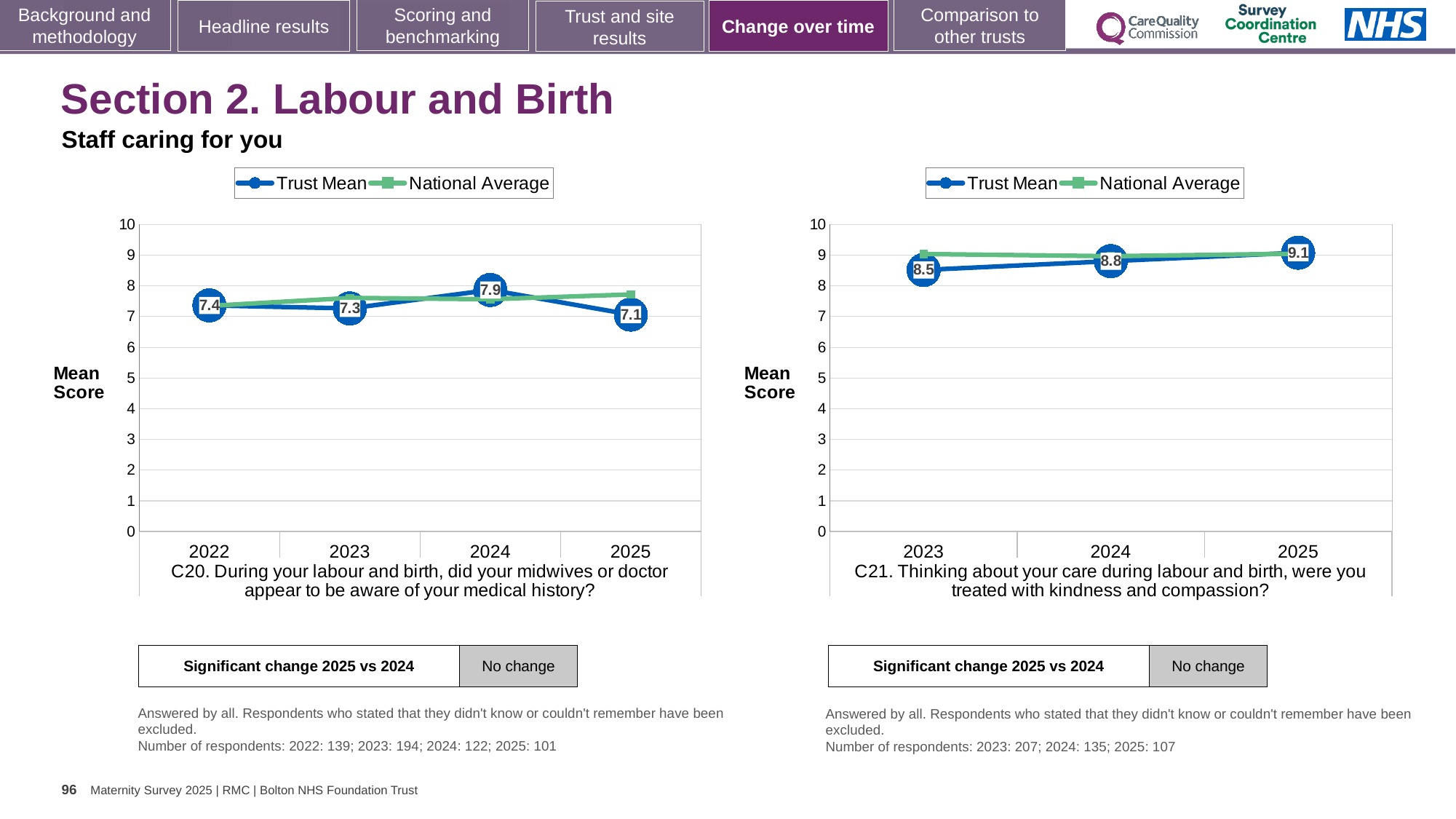
In the left chart (C20), is the Trust Mean higher in 2022 or 2023? 2022 In the left chart (C20), which year has the highest Trust Mean? 2024 In the left chart (C20), which year has the lowest Trust Mean? 2025 In the right chart (C21), is the National Average for 2023 greater or less than 8? greater How many series does the legend of the right chart (C21) list? 2 In the left chart (C20), what is the Trust Mean for 2024? 7.9 In the right chart (C21), what is the Trust Mean for 2025? 9.1 How many years are shown on the x axis of the left chart (C20)? 4 In the right chart (C21), does the Trust Mean rise or fall from 2023 to 2025? rise In the left chart (C20), what is the Trust Mean for 2025? 7.1 In the right chart (C21), what is the Trust Mean for 2023? 8.5 In the right chart (C21), what is the difference between the Trust Mean for 2025 and 2023? 0.6